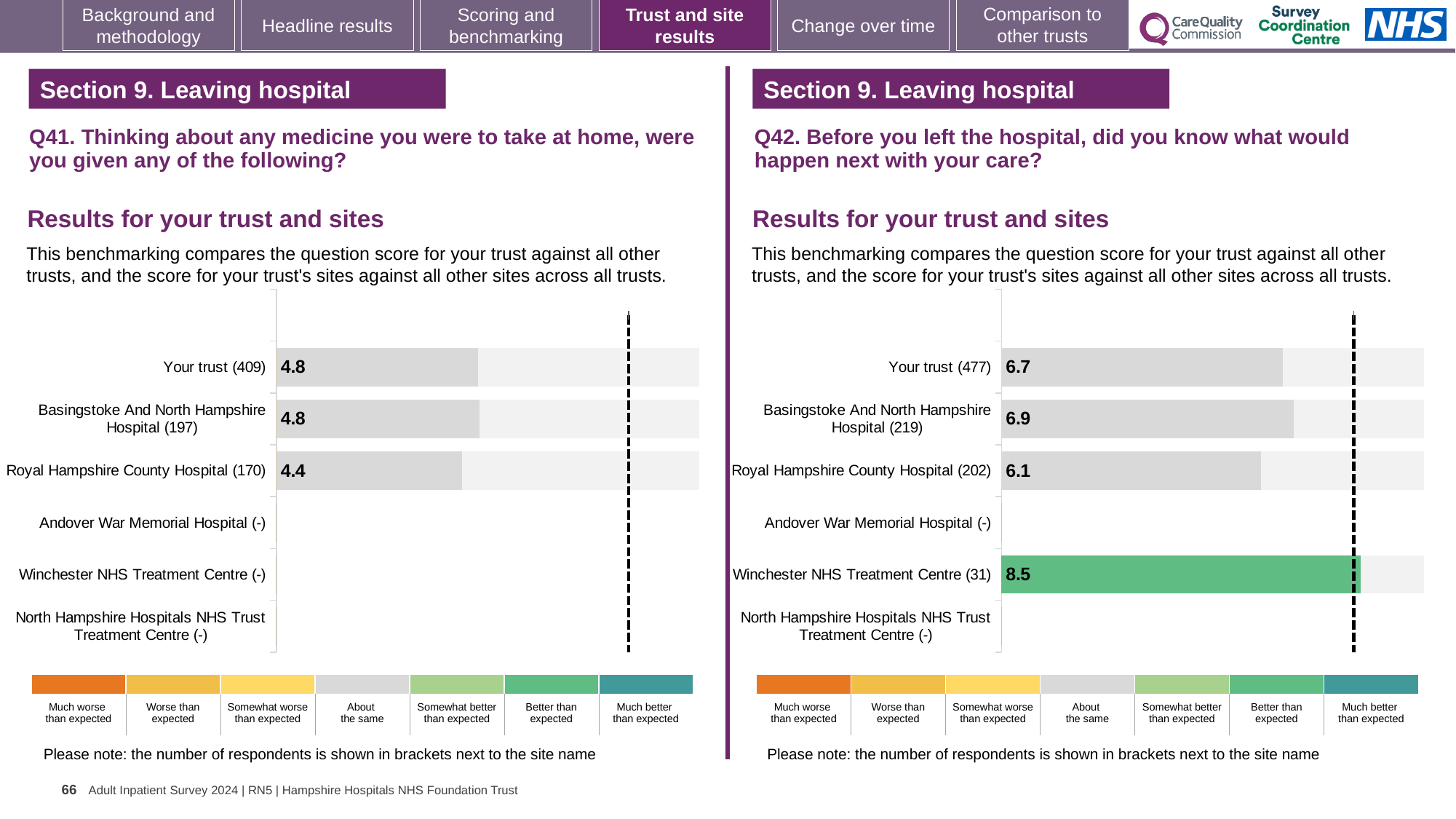
On the Q42 chart (right), what is the score for Basingstoke And North Hampshire Hospital? 6.9 On the Q42 chart (right), which site has the lowest score among those with a score shown? Royal Hampshire County Hospital On the Q42 chart (right), how many respondents are shown in brackets for Your trust? 477 On the Q41 chart (left), how many sites have a score shown (excluding Your trust)? 2 On the Q42 chart (right), which is larger: the score for Basingstoke And North Hampshire Hospital or the score for Your trust? Basingstoke And North Hampshire Hospital On the Q42 chart (right), which site has the highest score? Winchester NHS Treatment Centre On the Q41 chart (left), what is the difference between the scores for Your trust and Royal Hampshire County Hospital? 0.4 On the Q42 chart (right), what is the difference between the scores for Winchester NHS Treatment Centre and Royal Hampshire County Hospital? 2.4 On the Q41 chart (left), what is the score for Your trust? 4.8 On the Q42 chart (right), what is the score for Winchester NHS Treatment Centre? 8.5 What kind of chart is used on the Q42 chart (right)? Bar chart On the Q41 chart (left), what is the score for Royal Hampshire County Hospital? 4.4